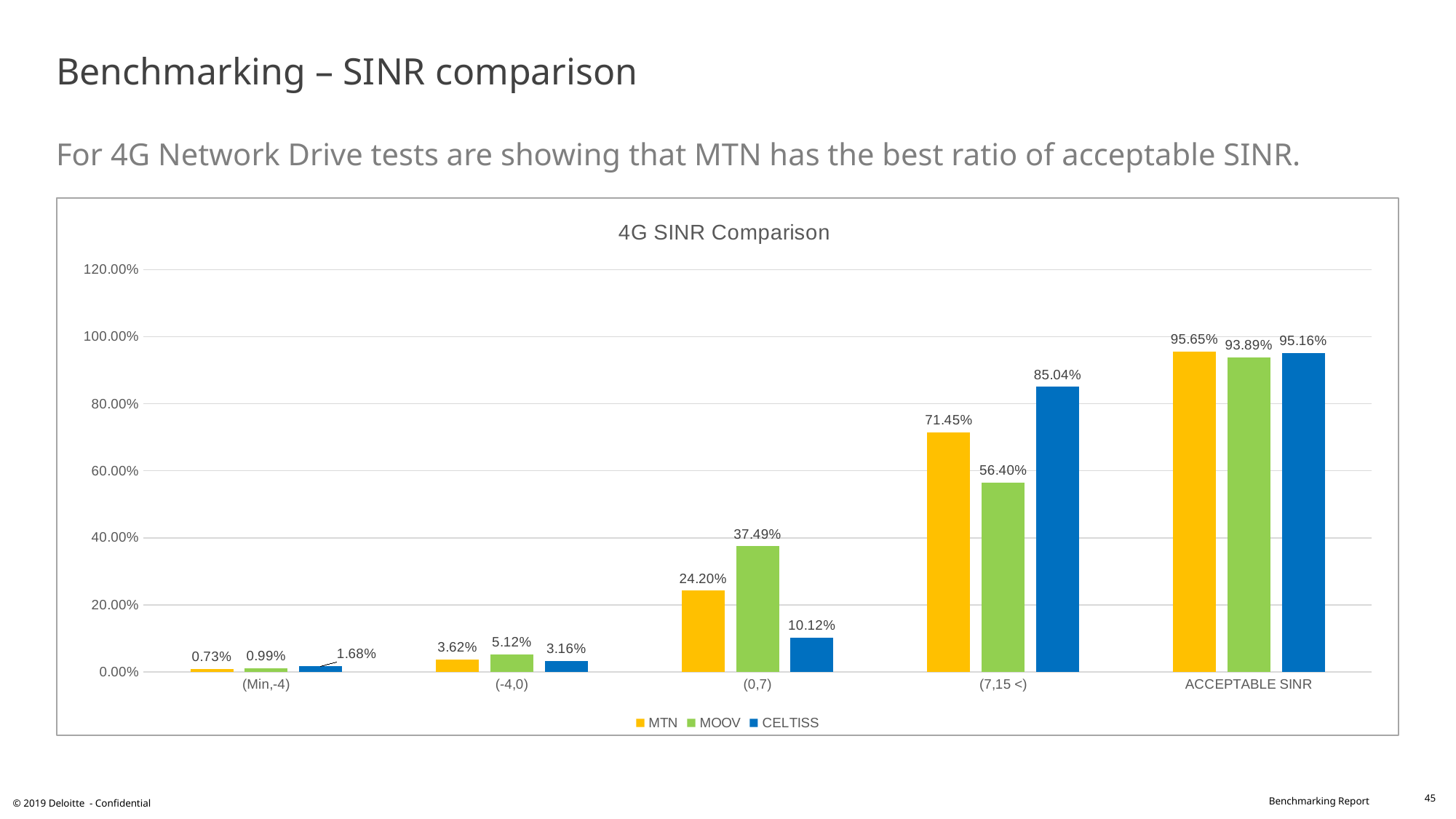
Which operator has the highest value in the ACCEPTABLE SINR category? MTN Is the value for MOOV in the (0,7) category greater or less than 40.00%? less What kind of chart is shown on the slide? Bar chart Which operator has the lowest value in the (0,7) category? CELTISS Which is larger in the (-4,0) category: the MOOV value or the CELTISS value? MOOV What is the value for MTN in the (0,7) category? 24.20% How many series does the legend list? 3 What is the value for CELTISS in the (7,15 <) category? 85.04% How many categories are shown on the x axis? 5 What is the value for MOOV in the ACCEPTABLE SINR category? 93.89% What is the difference between the MTN and MOOV values in the (7,15 <) category? 15.05% What is the title of the chart? 4G SINR Comparison